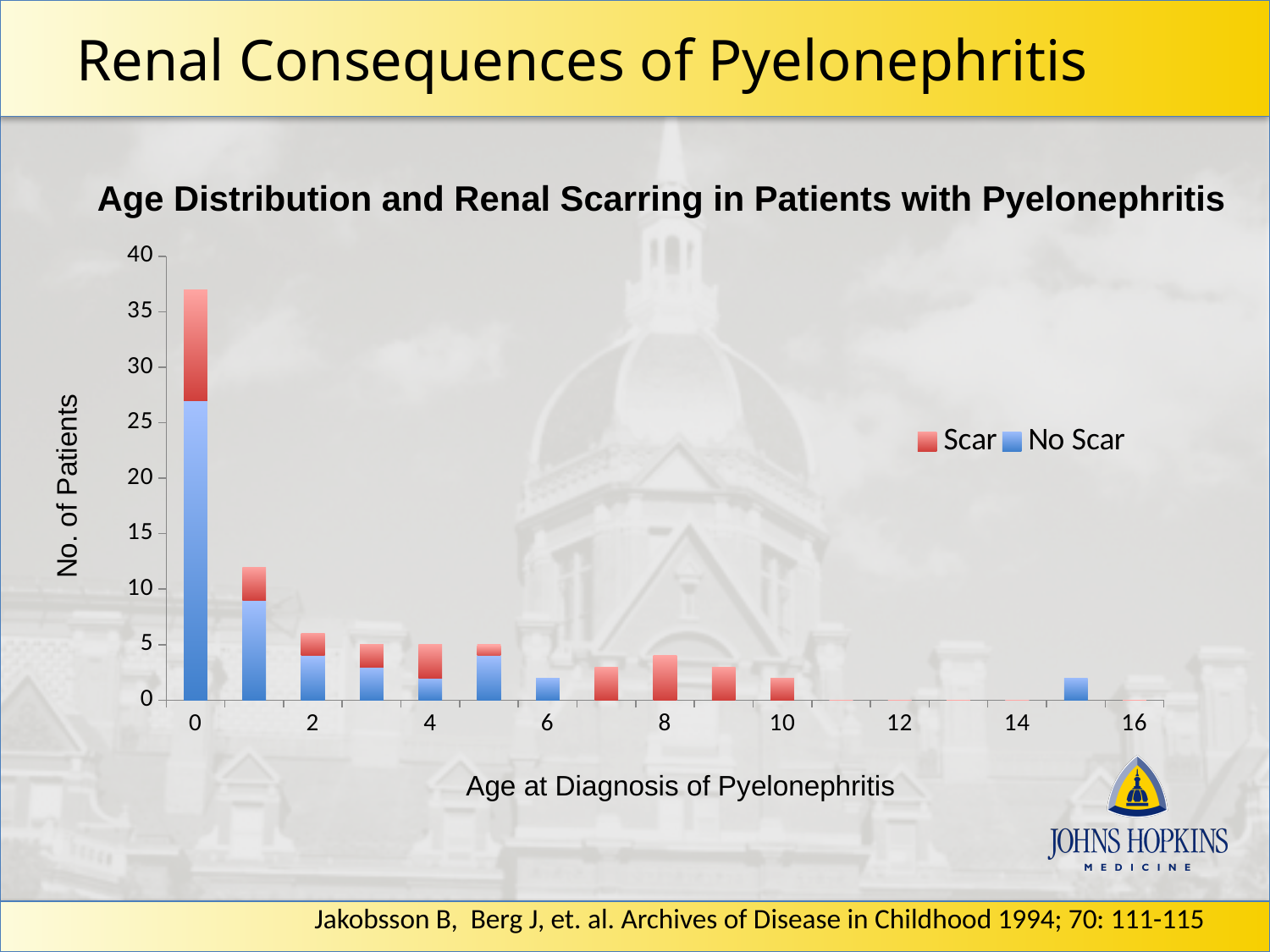
How many series does the legend list? 2 Do the total numbers of patients generally rise or fall as age at diagnosis increases? fall Is the total number of patients at age 1 greater or less than 10? greater What are the two series named in the legend? Scar and No Scar What is the title of the chart? Age Distribution and Renal Scarring in Patients with Pyelonephritis Which has more total patients, age 0 or age 1? age 0 What kind of chart is shown on the slide? bar chart How many ages have a bar plotted on the chart? 12 Is the No Scar value at age 0 greater or less than 25? greater Is the total number of patients at age 8 greater or less than 5? less Which age at diagnosis has the highest total number of patients? 0